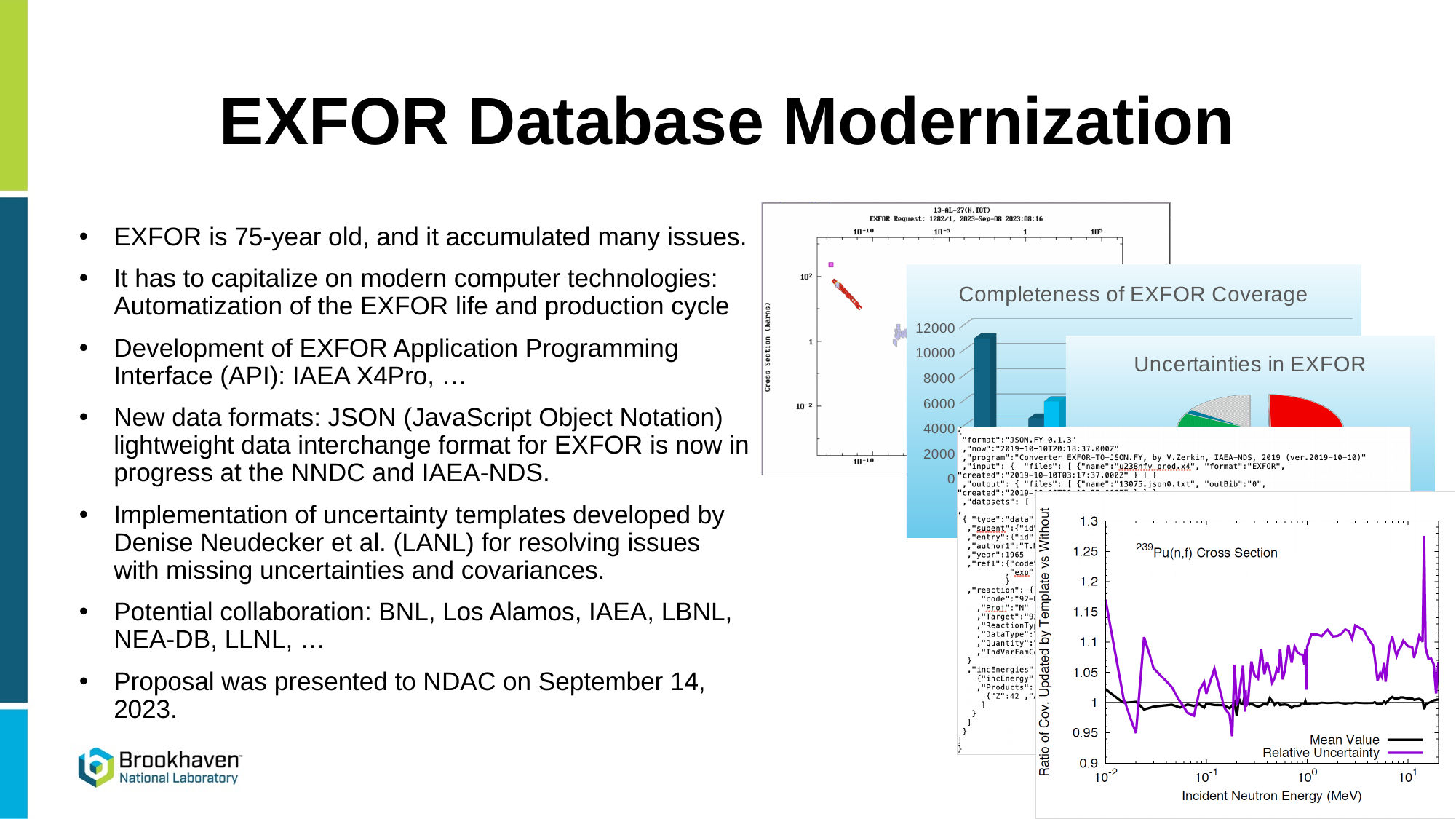
In the 'Completeness of EXFOR Coverage' chart, is the value of the tallest (leftmost) bar greater or less than 10000? greater How many series does the legend of the '239Pu(n,f) Cross Section' chart list? 2 In the '239Pu(n,f) Cross Section' chart, is the peak value of the Relative Uncertainty series greater or less than 1.2? greater What kind of chart is the '239Pu(n,f) Cross Section' chart in the bottom right? line chart In the '239Pu(n,f) Cross Section' chart, which series reaches the higher maximum value, Mean Value or Relative Uncertainty? Relative Uncertainty What is the title of the bar chart on the slide? Completeness of EXFOR Coverage In the '239Pu(n,f) Cross Section' chart, which series is plotted in purple? Relative Uncertainty What kind of chart is the 'Completeness of EXFOR Coverage' chart? bar chart In the '239Pu(n,f) Cross Section' chart, is the Mean Value series at an incident neutron energy of 10^0 MeV greater or less than 1.1? less What is the x-axis label of the '239Pu(n,f) Cross Section' chart? Incident Neutron Energy (MeV) What kind of chart is the 'Uncertainties in EXFOR' chart? pie chart